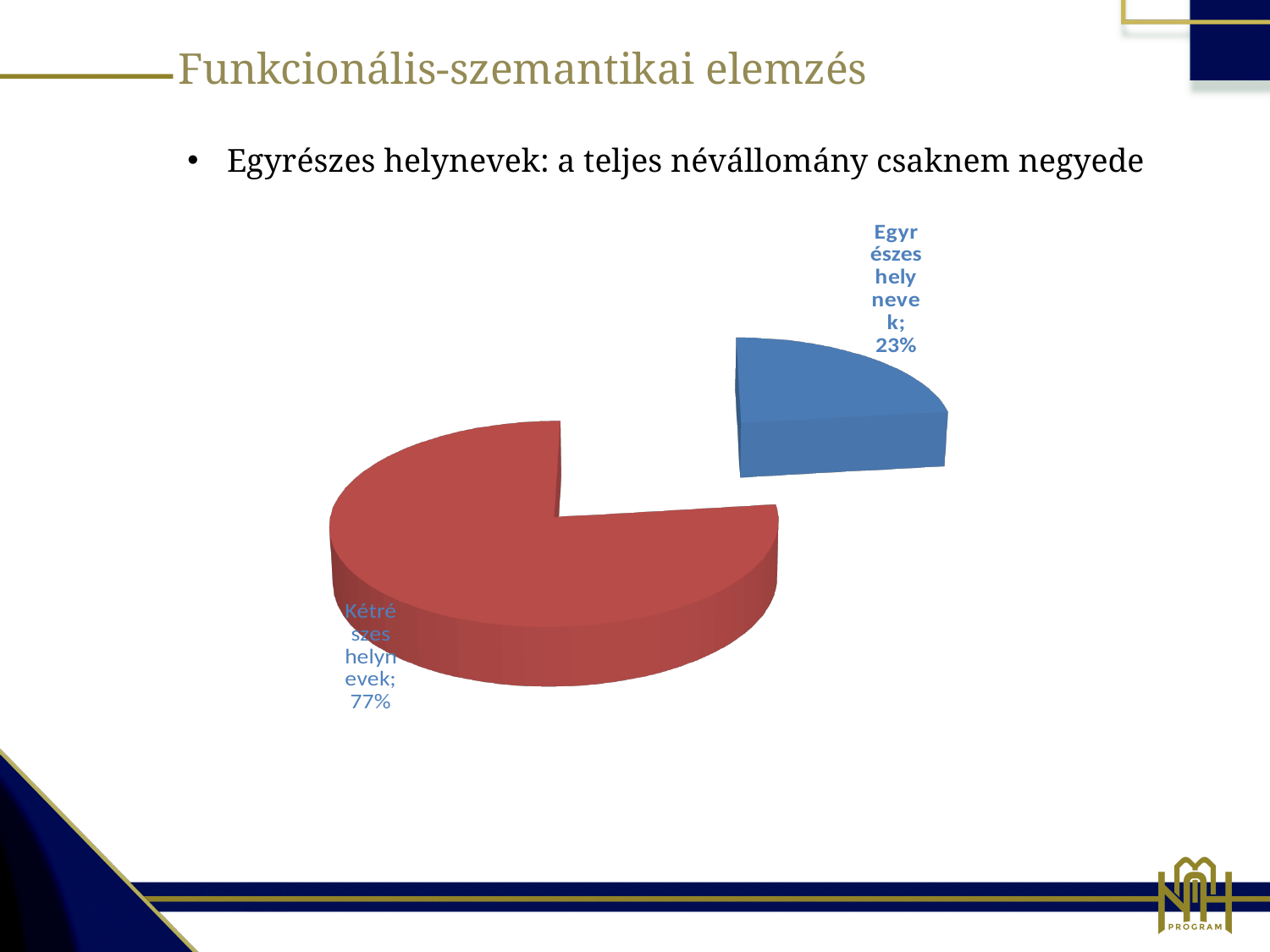
What kind of chart is shown on the slide? pie chart What share of the pie does "Kétrészes helynevek" represent? 77% What colour is the "Kétrészes helynevek" slice? red How many slices does the pie chart have? 2 Which is larger, the "Egyrészes helynevek" slice or the "Kétrészes helynevek" slice? Kétrészes helynevek What is the difference in percentage points between the "Kétrészes helynevek" and "Egyrészes helynevek" slices? 54 What colour is the "Egyrészes helynevek" slice? blue Which slice of the pie is the smallest? Egyrészes helynevek Which slice of the pie is the largest? Kétrészes helynevek What share of the pie does "Egyrészes helynevek" represent? 23% What is the total of the two percentages shown on the pie chart? 100%